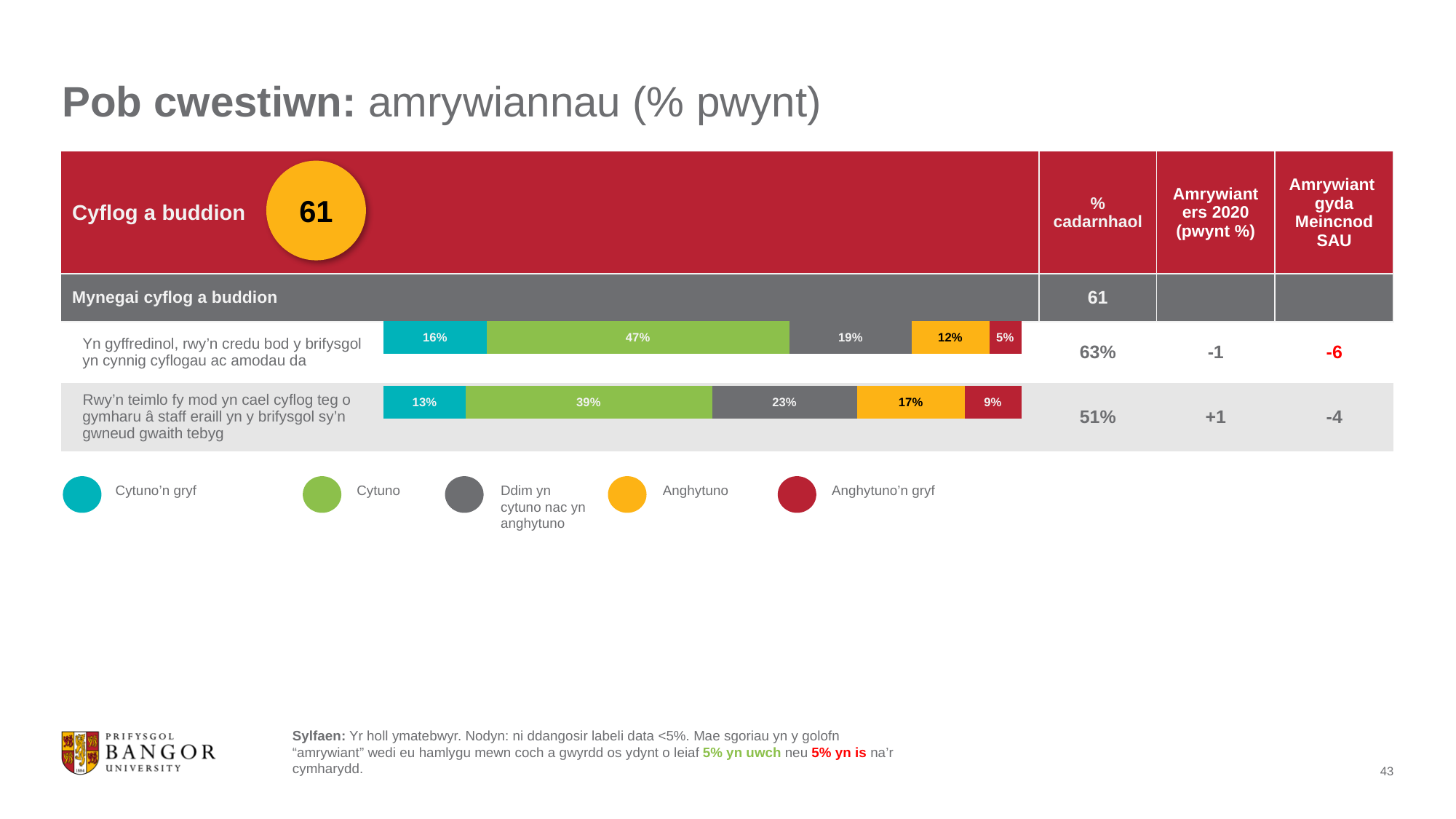
What is the index score shown in the yellow circle next to 'Cyflog a buddion'? 61 What percentage of respondents answered 'Cytuno' (agree) for the statement 'Yn gyffredinol, rwy'n credu bod y brifysgol yn cynnig cyflogau ac amodau da'? 47% How many response categories does the legend list? 5 What is the '% cadarnhaol' value for the statement 'Yn gyffredinol, rwy'n credu bod y brifysgol yn cynnig cyflogau ac amodau da'? 63% What is the 'Amrywiant gyda Meincnod SAU' value for the statement 'Rwy'n teimlo fy mod yn cael cyflog teg o gymharu â staff eraill yn y brifysgol sy'n gwneud gwaith tebyg'? -4 What kind of chart is used to show the response distributions? Stacked bar chart What percentage answered 'Anghytuno'n gryf' (strongly disagree) for the statement 'Rwy'n teimlo fy mod yn cael cyflog teg o gymharu â staff eraill yn y brifysgol sy'n gwneud gwaith tebyg'? 9% Which statement has the higher 'Ddim yn cytuno nac yn anghytuno' percentage? Rwy'n teimlo fy mod yn cael cyflog teg o gymharu â staff eraill yn y brifysgol sy'n gwneud gwaith tebyg How many statements (bars) are shown in the chart? 2 Which response category has the smallest share for the statement 'Yn gyffredinol, rwy'n credu bod y brifysgol yn cynnig cyflogau ac amodau da'? Anghytuno'n gryf What is the difference between the 'Cytuno'n gryf' percentages of the two statements? 3% Which response category has the largest share for the statement 'Rwy'n teimlo fy mod yn cael cyflog teg o gymharu â staff eraill yn y brifysgol sy'n gwneud gwaith tebyg'? Cytuno